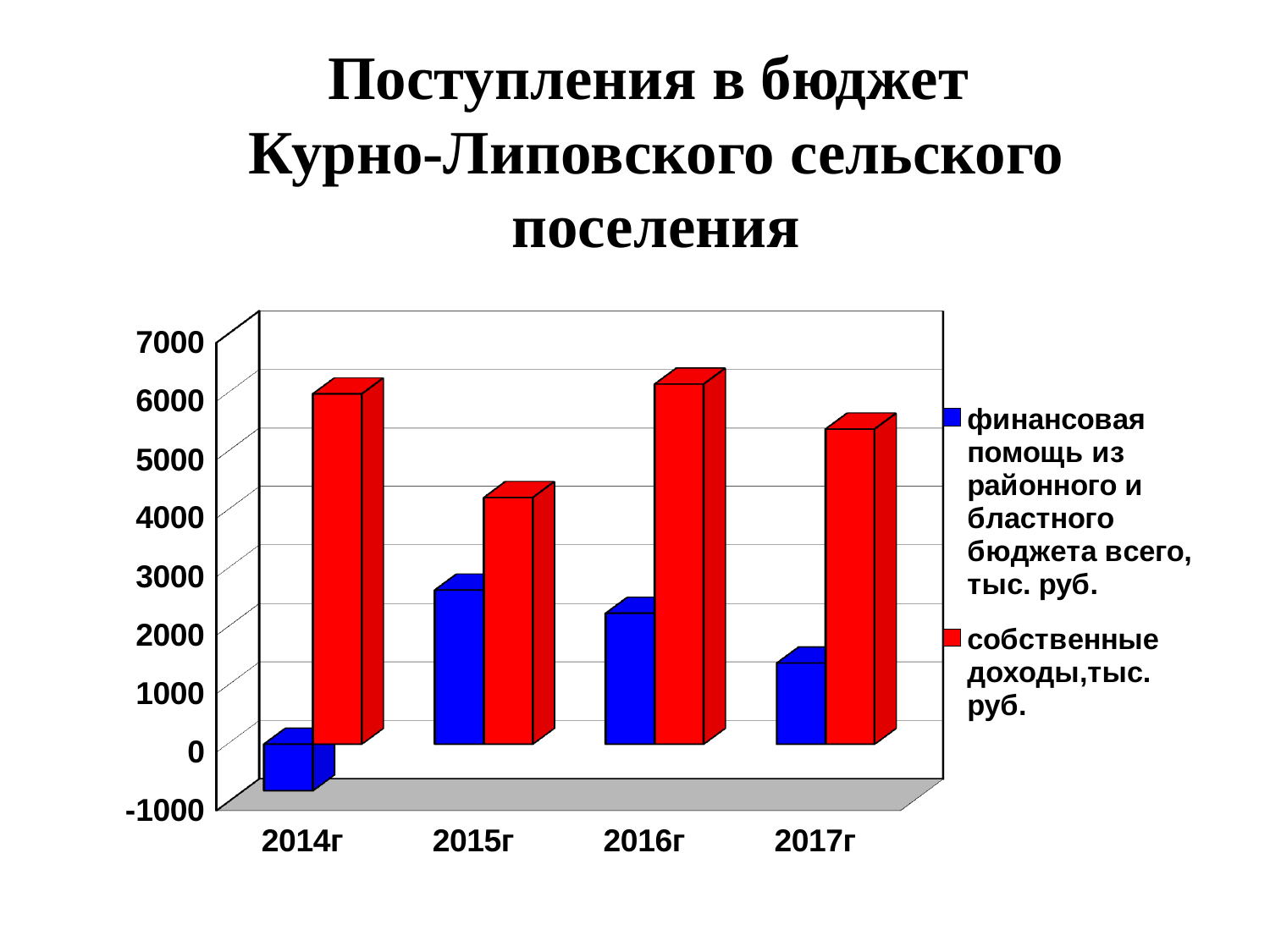
Which is larger: финансовая помощь in 2015г or in 2017г? 2015г Is the value for финансовая помощь in 2014г greater or less than 0? less How many series does the chart legend list? 2 Is the value for финансовая помощь in 2017г greater or less than 2000? less Does the value for финансовая помощь rise or fall from 2015г to 2017г? fall Is the value for собственные доходы in 2015г greater or less than 5000? less How many years are shown on the x axis of the chart? 4 Which year has the lowest value for собственные доходы, тыс. руб.? 2015г What kind of chart is shown on the slide? bar chart Which year has the highest value for финансовая помощь из районного и бластного бюджета всего, тыс. руб.? 2015г Which year has the lowest value for финансовая помощь из районного и бластного бюджета всего, тыс. руб.? 2014г